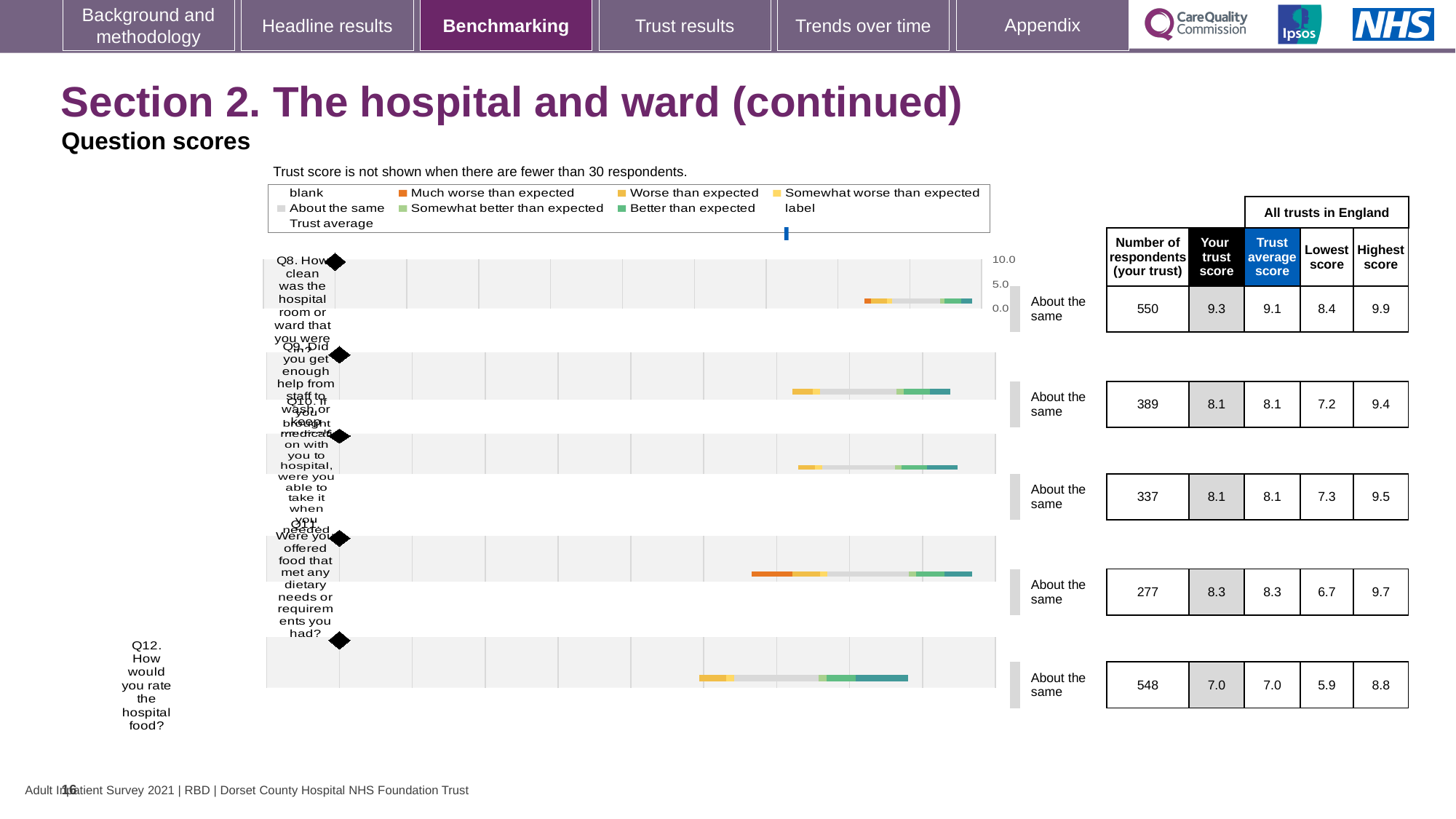
What is the 'Your trust score' for Q12 (How would you rate the hospital food)? 7.0 For Q8, what is the difference between the highest score and the lowest score across all trusts in England? 1.5 Which question has the lowest 'Your trust score'? Q12 How many respondents answered Q10 at your trust? 337 What colour does the legend use for 'Much worse than expected'? Orange What is the lowest score across all trusts in England for Q12? 5.9 Which question has the highest 'Your trust score'? Q8 Which has the larger 'Your trust score', Q9 or Q11? Q11 What is the 'Your trust score' for Q8 (How clean was the hospital room or ward)? 9.3 How many questions (Q8 to Q12) are plotted in the chart? 5 What kind of chart is used to show the question scores on this slide? bar chart